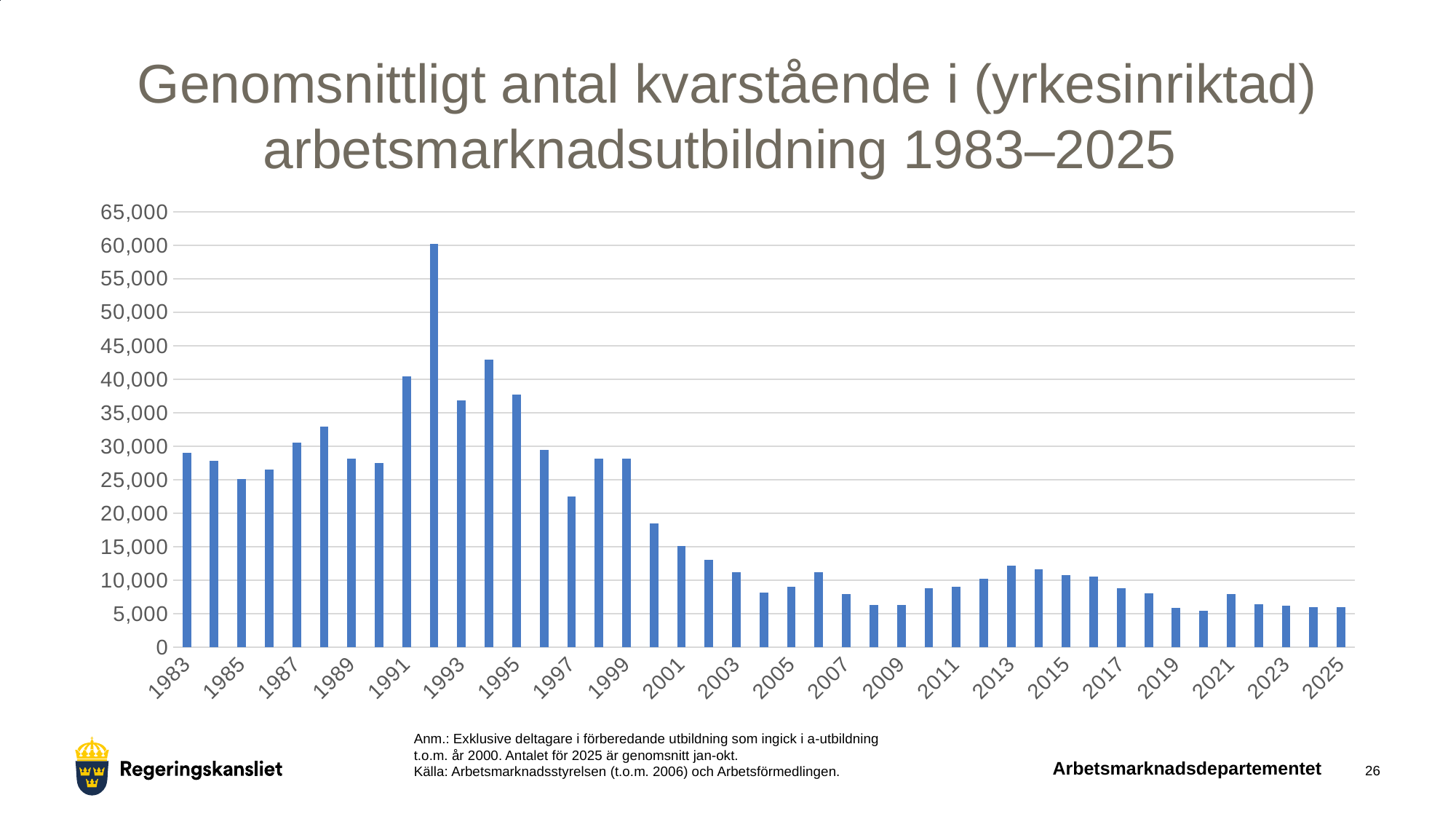
What kind of chart is shown on the slide? bar chart Do the values generally rise or fall from 1992 to 2000? fall Is the value for 1983 greater or less than 30,000? less Which year has the larger value, 1997 or 1998? 1998 Is the value for 1992 greater or less than 55,000? greater Which year has the highest value in the chart? 1992 Is the value for 2025 greater or less than 10,000? less Which year has the larger value, 1991 or 1994? 1994 What is the title of the chart? Genomsnittligt antal kvarstående i (yrkesinriktad) arbetsmarknadsutbildning 1983–2025